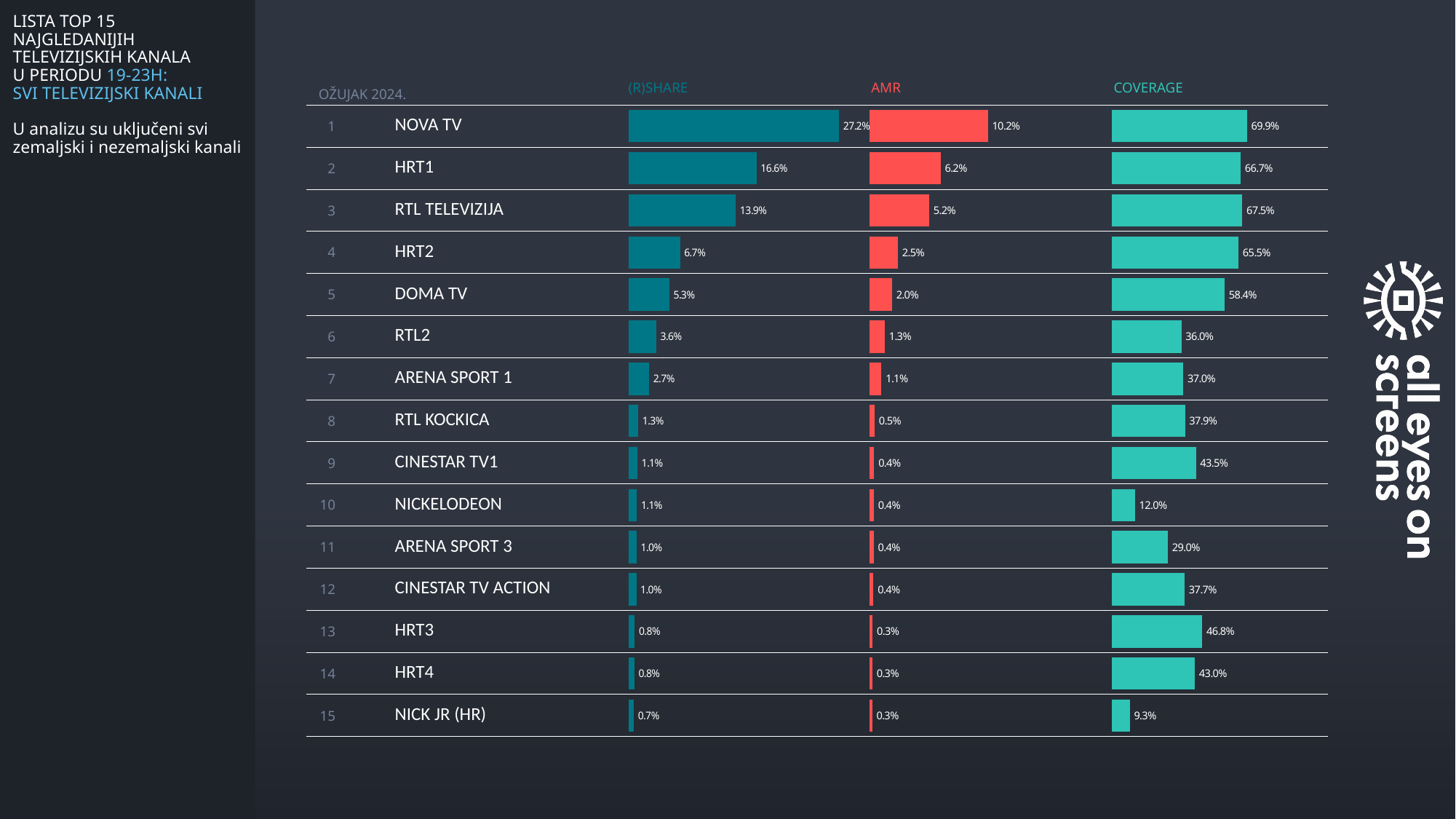
In the COVERAGE chart, which is larger, RTL2 or CINESTAR TV1? CINESTAR TV1 How many channels are listed in the (R)SHARE chart? 15 In the COVERAGE chart, which channel has the lowest value? NICK JR (HR) Do the (R)SHARE values rise or fall going down the list from rank 1 to rank 15? fall In the (R)SHARE chart, what is the difference between NOVA TV and HRT1? 10.6% In the (R)SHARE chart, what is the value for NOVA TV? 27.2% In the COVERAGE chart, which is larger, HRT3 or HRT4? HRT3 In the COVERAGE chart, what is the value for DOMA TV? 58.4% What kind of chart is used to show the AMR values? bar chart In the COVERAGE chart, which channel has the highest value? NOVA TV In the AMR chart, what is the difference between NOVA TV and RTL TELEVIZIJA? 5.0% In the AMR chart, what is the value for HRT1? 6.2%